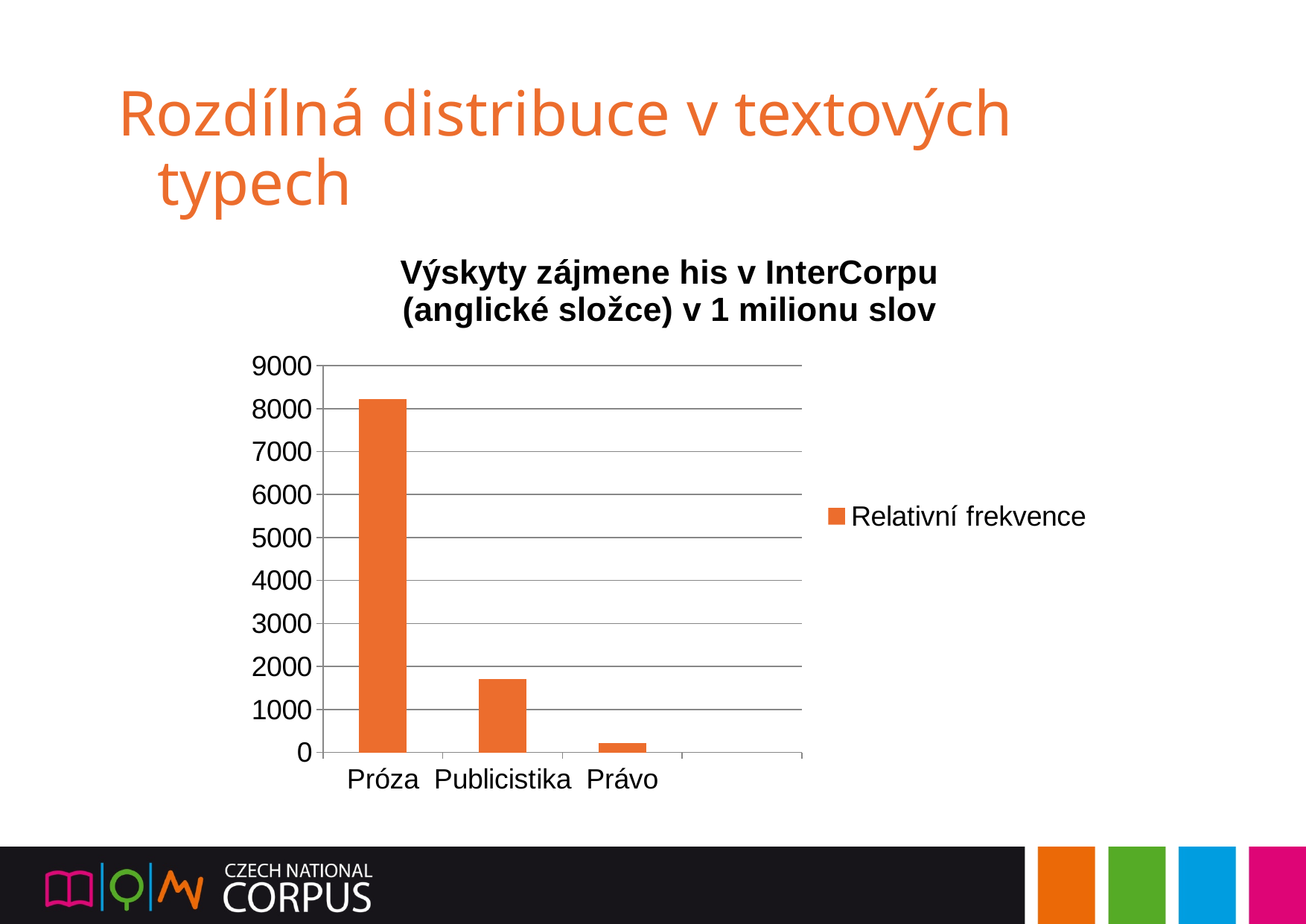
What is the name of the series in the legend? Relativní frekvence Is the value for Próza greater or less than 8000? greater Do the values rise or fall from Próza to Právo along the x axis? fall Is the value for Publicistika greater or less than 1000? greater How many series does the legend list? 1 Is the value for Publicistika greater or less than 2000? less Which category has the highest value? Próza How many categories are shown on the x axis? 3 Which category has the lowest value? Právo Which is larger, the value for Publicistika or the value for Právo? Publicistika What kind of chart is shown? bar chart